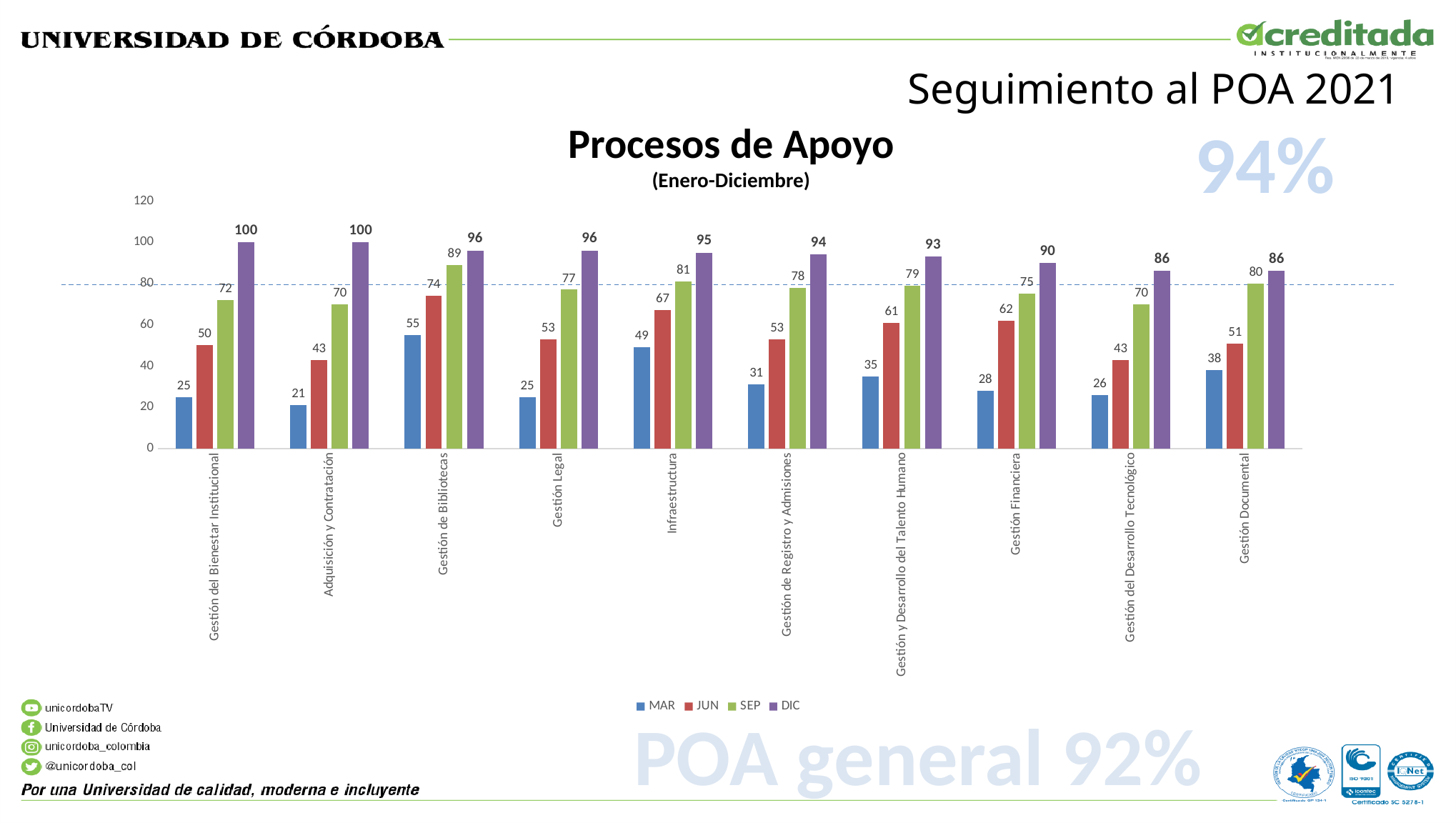
Which category has the highest MAR value? Gestión de Bibliotecas What is the subtitle shown under the chart title 'Procesos de Apoyo'? (Enero-Diciembre) What is the difference between the DIC and MAR values for Gestión Legal? 71 What is the DIC value for Gestión de Bibliotecas? 96 What is the MAR value for Infraestructura? 49 What kind of chart is shown on the slide? Bar chart Which is larger, the SEP value for Infraestructura or the SEP value for Gestión Financiera? Infraestructura Which category has the lowest MAR value? Adquisición y Contratación How many categories are shown on the x axis? 10 How many series does the legend list? 4 What is the SEP value for Gestión Documental? 80 What is the JUN value for Gestión Financiera? 62